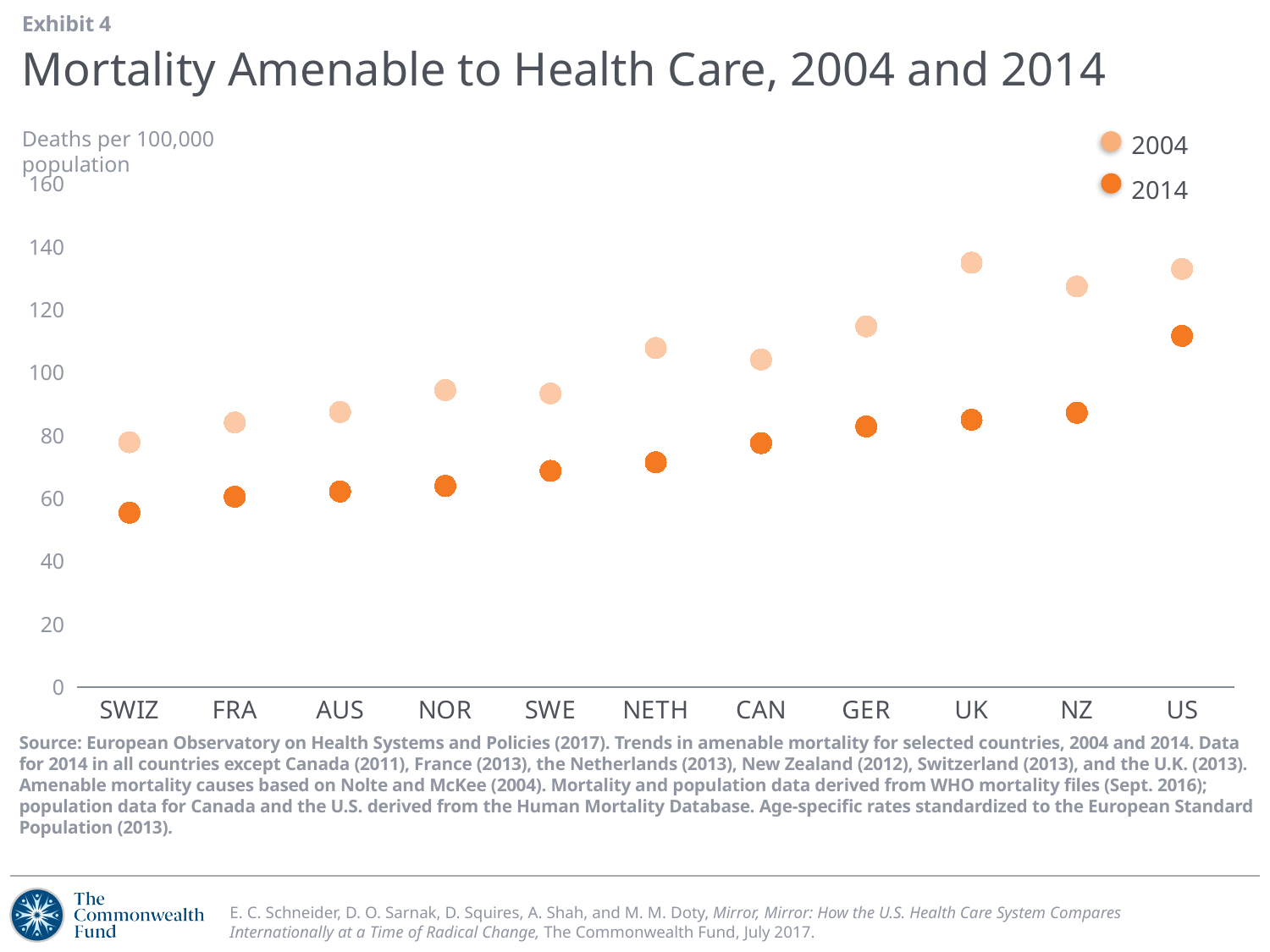
Is the 2004 value for the UK greater or less than 120? greater Which is larger, the 2014 value for the US or the 2014 value for NZ? US Is the 2004 value for NETH greater or less than 100? greater Which country has the lowest value for 2004? SWIZ Is the 2014 value for the US greater or less than 100? greater What kind of chart is shown on the slide? Scatter (dot) chart Do the 2014 values generally rise or fall moving from SWIZ to US along the x axis? rise How many countries are shown on the x axis? 11 Which country has the highest value for 2014? US How many series does the legend list? 2 Which country has the lowest value for 2014? SWIZ